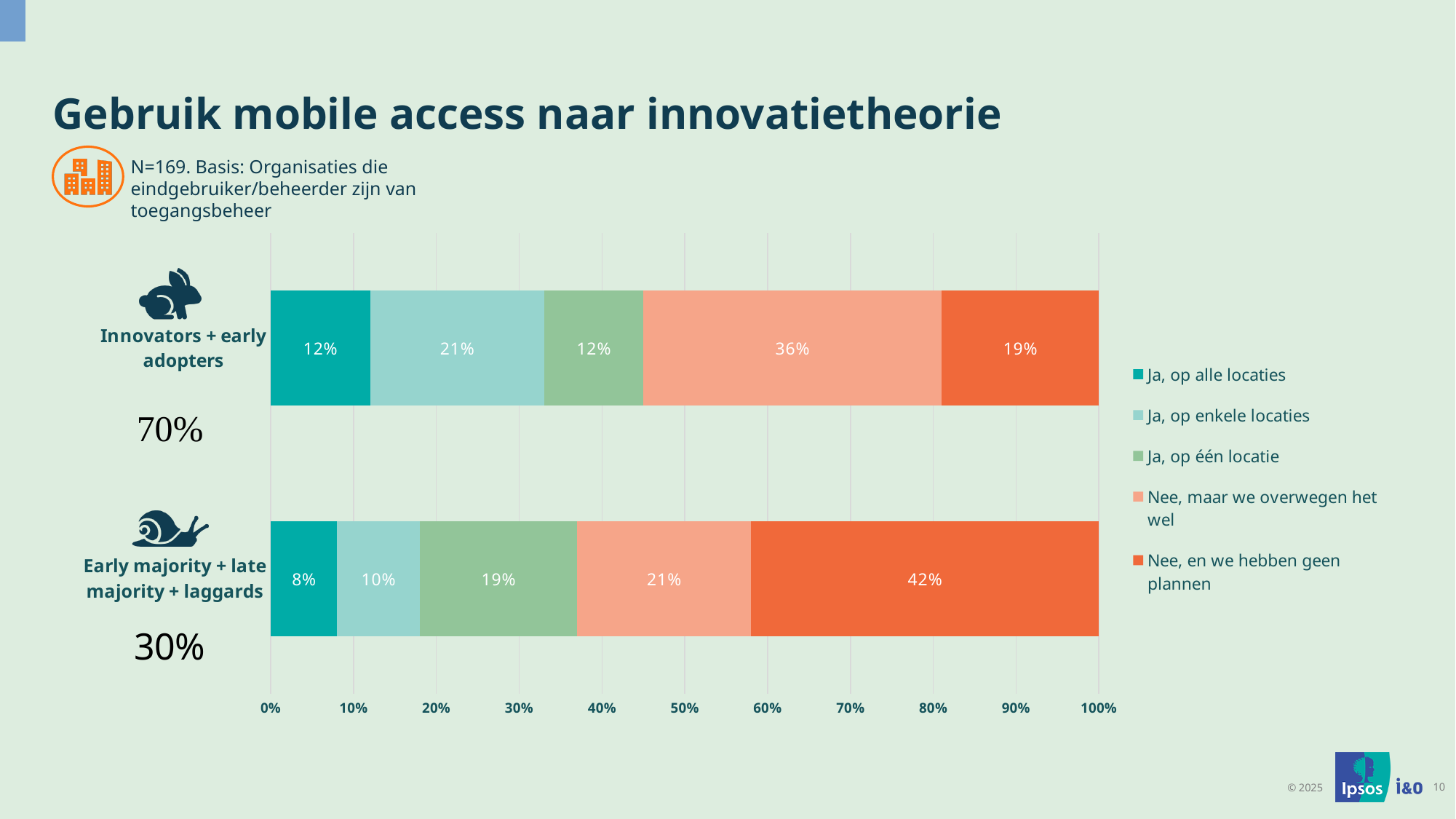
What is the value for "Nee, en we hebben geen plannen" in the "Early majority + late majority + laggards" bar? 42% What is the difference between the "Nee, en we hebben geen plannen" values for the two groups? 23 percentage points How many series does the legend list? 5 What kind of chart is shown on the slide? Stacked bar chart How many categories (bars) does the chart show? 2 Which series has the largest share in the "Early majority + late majority + laggards" bar? Nee, en we hebben geen plannen What is the value for "Ja, op één locatie" in the "Early majority + late majority + laggards" bar? 19% Which series has the smallest share in the "Early majority + late majority + laggards" bar? Ja, op alle locaties What is the value for "Nee, maar we overwegen het wel" in the "Innovators + early adopters" bar? 36% What is the title of the slide? Gebruik mobile access naar innovatietheorie Which group has the larger value for "Ja, op enkele locaties"? Innovators + early adopters What is the value for "Ja, op alle locaties" in the "Innovators + early adopters" bar? 12%